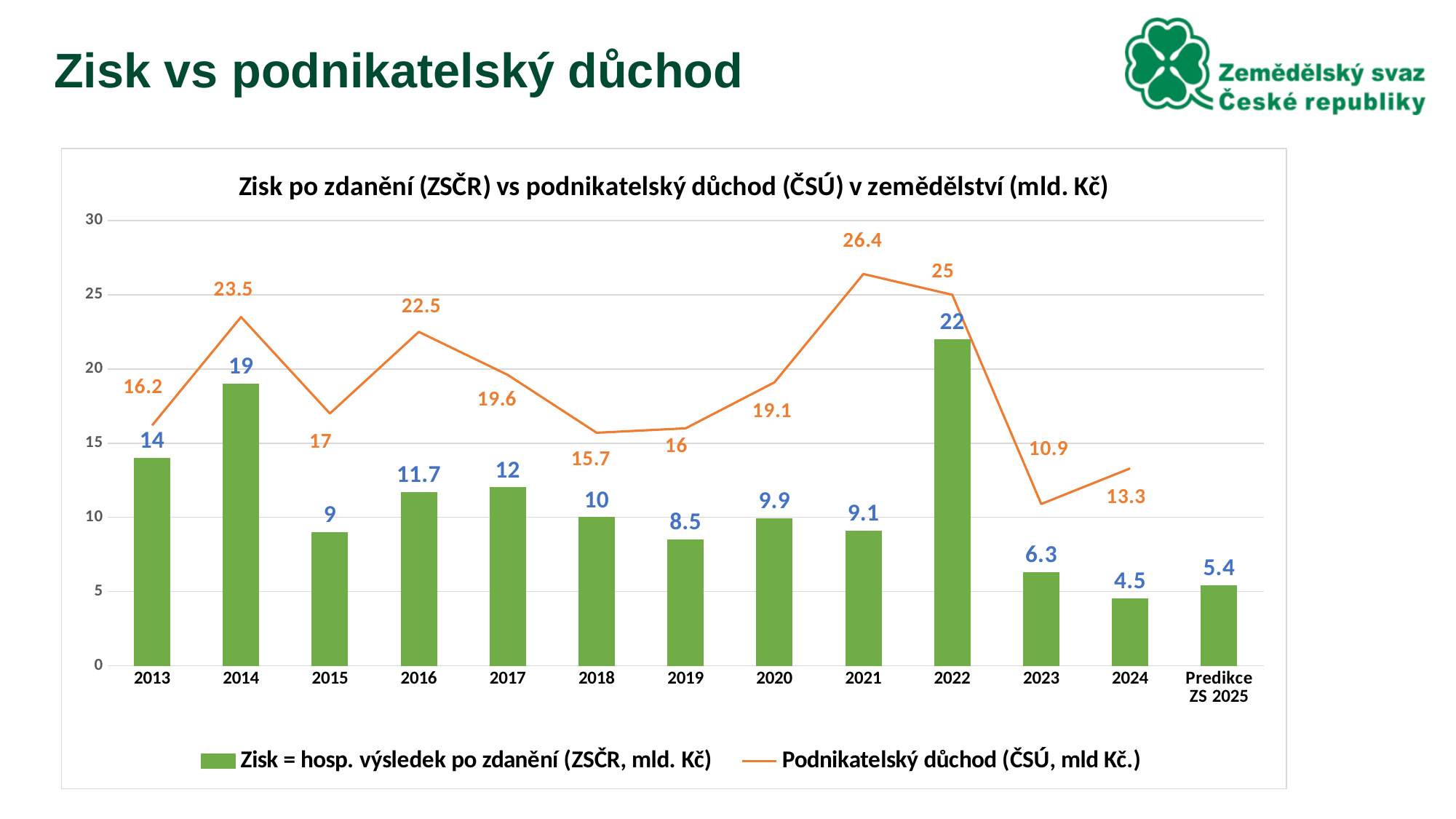
Does the Zisk bar rise or fall from 2022 to 2024? Fall What is the difference between Podnikatelský důchod and Zisk in 2014? 4.5 What is the value of Zisk (hosp. výsledek po zdanění) for 2022? 22 In which year is the Zisk bar the lowest? 2024 What is the value of Podnikatelský důchod (ČSÚ) for 2021? 26.4 How many categories are shown on the x axis? 13 What colour is the Podnikatelský důchod line? Orange What kind of chart is shown on the slide? Combined bar and line chart What is the Zisk value shown for Predikce ZS 2025? 5.4 Which is larger in 2023: the Zisk bar or the Podnikatelský důchod line? Podnikatelský důchod In which year is the Podnikatelský důchod line at its highest? 2021 How many series does the legend list? 2